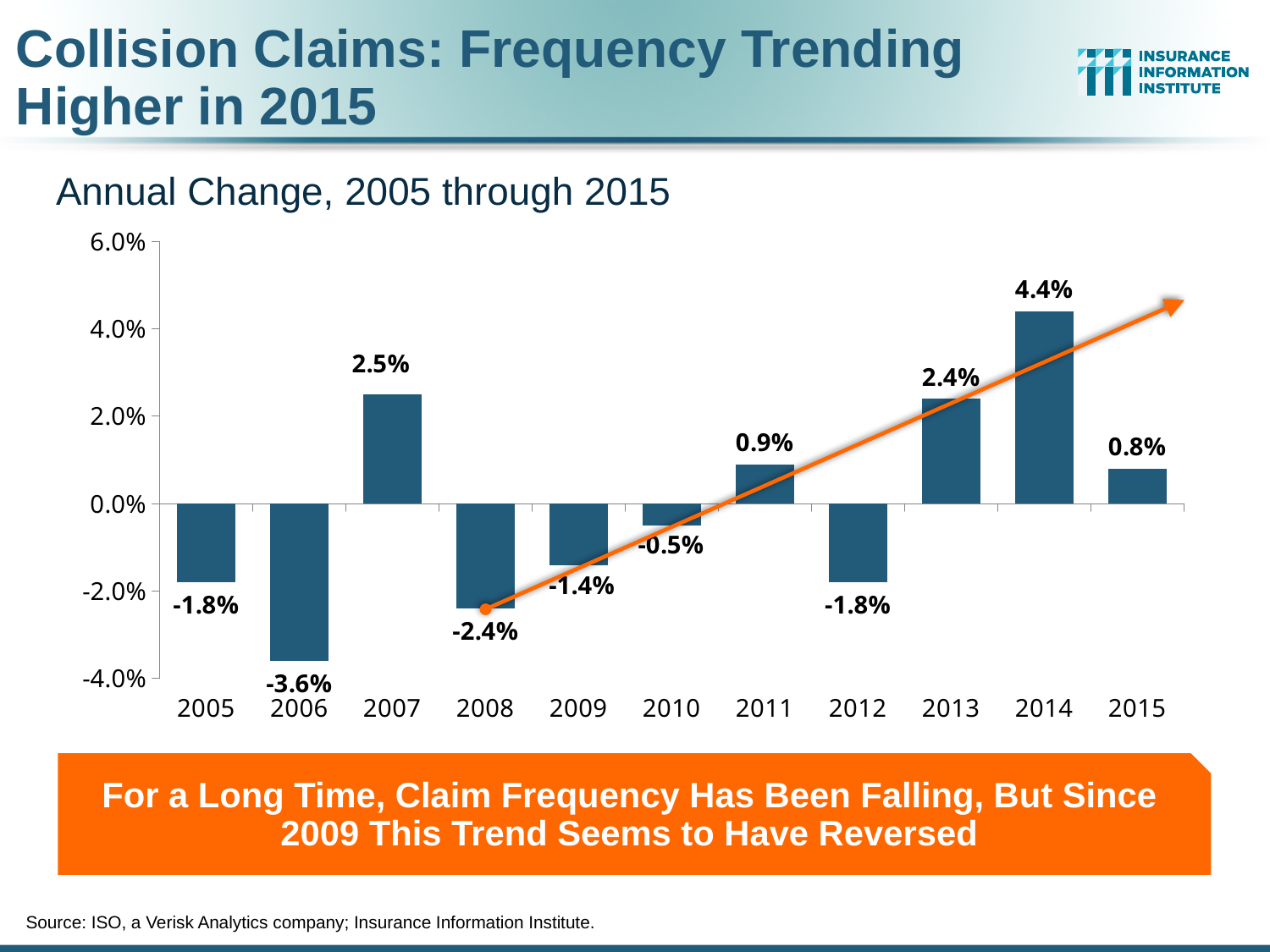
What is the subtitle printed above the chart? Annual Change, 2005 through 2015 From 2012 to 2014, do the annual change values rise or fall? Rise How many years are shown on the x axis of the chart? 11 What is the annual change in collision claim frequency for 2006? -3.6% Which year has the highest annual change in collision claim frequency? 2014 What kind of chart is used to show the annual change in collision claim frequency? Bar chart Which year has a larger annual change, 2007 or 2015? 2007 What is the difference between the annual change in 2014 and the annual change in 2013? 2.0% What is the annual change in collision claim frequency for 2011? 0.9% Is the value for 2014 greater or less than 4.0%? greater Which year has the lowest annual change in collision claim frequency? 2006 What is the annual change in collision claim frequency for 2014? 4.4%